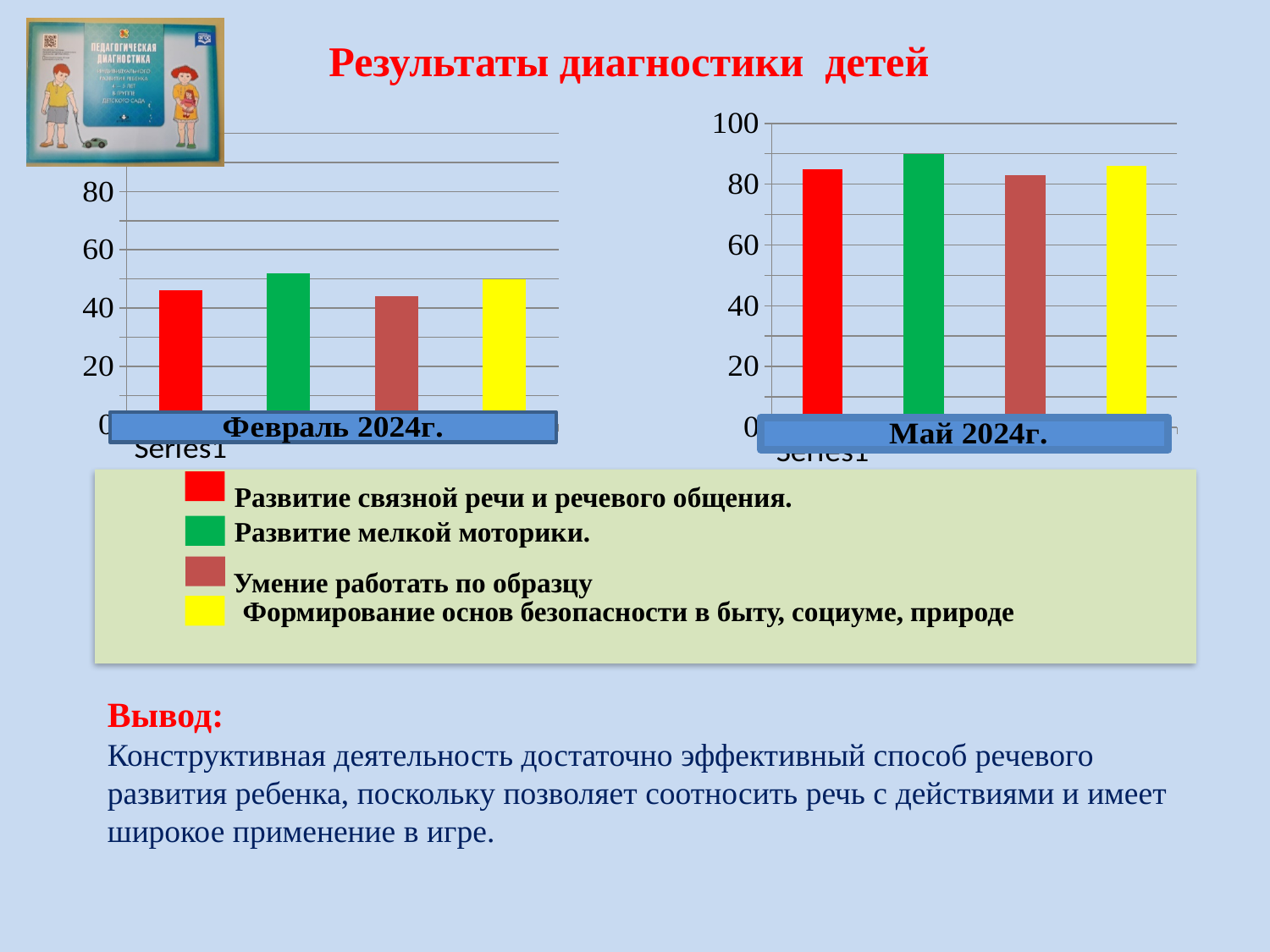
According to the legend, which category is shown in red? Развитие связной речи и речевого общения In the 'Май 2024г.' chart, is the value for 'Умение работать по образцу' greater or less than 80? greater What kind of chart is the 'Февраль 2024г.' chart? bar chart Which is larger: the value for 'Развитие связной речи и речевого общения' in the 'Февраль 2024г.' chart or in the 'Май 2024г.' chart? Май 2024г. In the 'Май 2024г.' chart, which is larger: 'Развитие мелкой моторики' or 'Умение работать по образцу'? Развитие мелкой моторики How many bars are plotted in the 'Май 2024г.' chart? 4 In the 'Февраль 2024г.' chart, is the value for 'Развитие связной речи и речевого общения' greater or less than 40? greater In the 'Февраль 2024г.' chart, is the value for 'Развитие мелкой моторики' greater or less than 60? less In the 'Май 2024г.' chart, which category has the highest bar? Развитие мелкой моторики According to the legend, what colour represents 'Формирование основ безопасности в быту, социуме, природе'? yellow